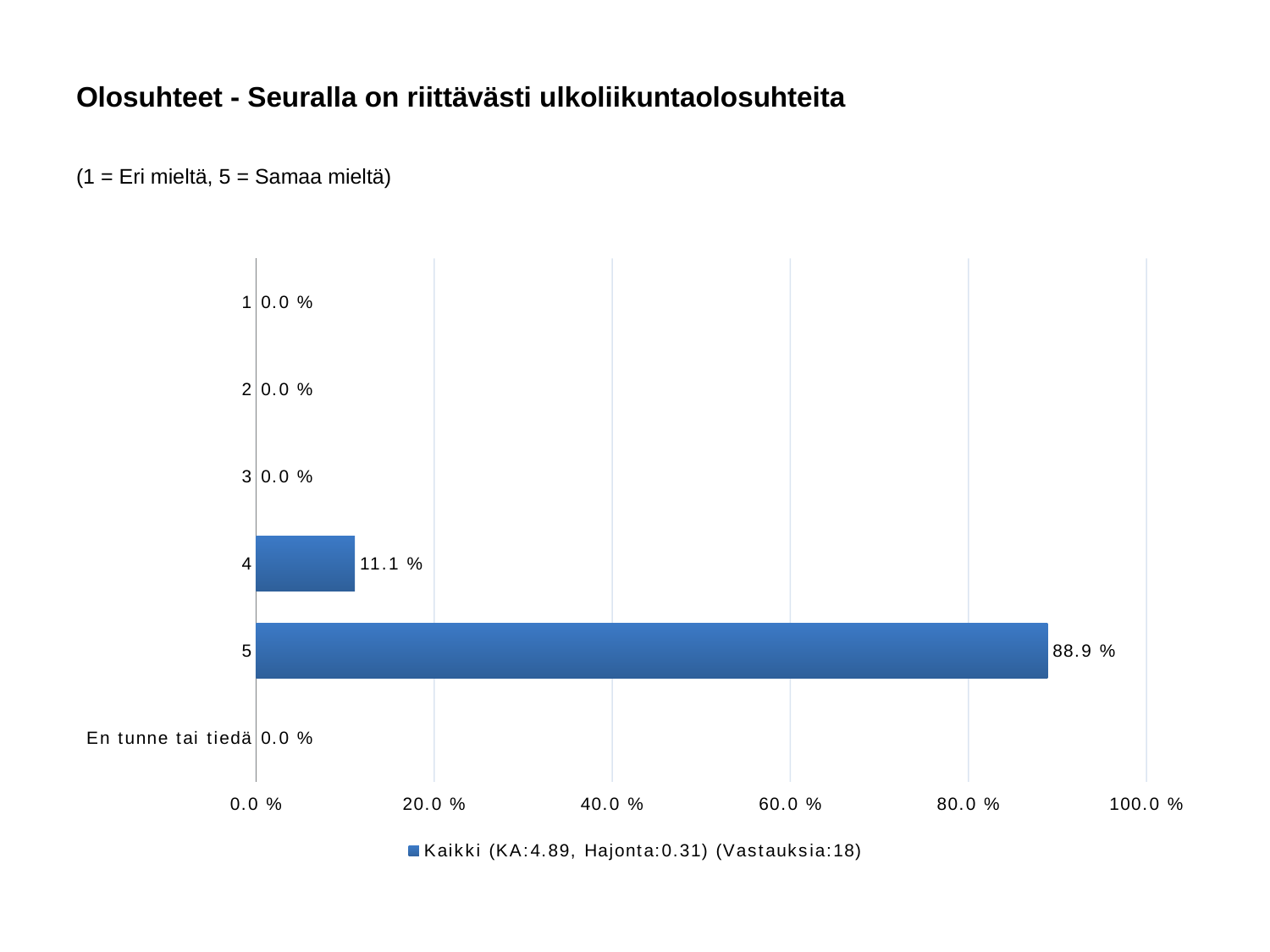
How many categories are shown on the chart? 6 What is the value for category 4? 11.1 % What is the legend entry for the series? Kaikki (KA:4.89, Hajonta:0.31) (Vastauksia:18) Is the value for category 5 greater or less than 80.0 %? greater What kind of chart is shown on the slide? bar chart What is the value for category 5? 88.9 % Which is larger, the value for category 4 or the value for category 5? 5 What is the value for the category 'En tunne tai tiedä'? 0.0 % What is the value for category 1? 0.0 % Which category has the highest value? 5 What is the difference between the values for category 5 and category 4? 77.8 % How many series does the legend list? 1